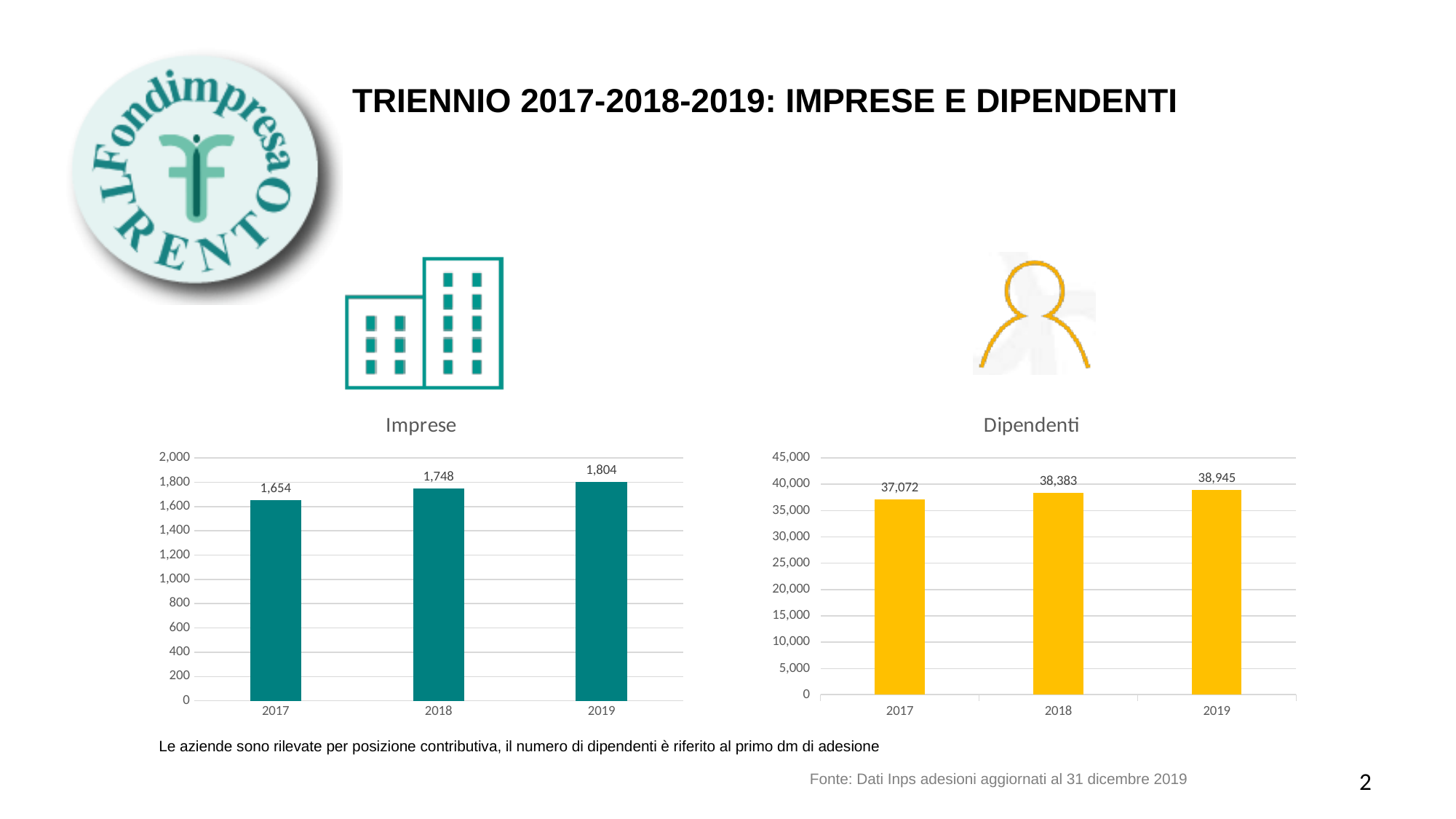
What kind of chart is the Dipendenti chart? bar chart In the Imprese chart, what is the difference between the 2019 and 2017 values? 150 In the Dipendenti chart, what is the value for 2018? 38,383 In the Imprese chart, what is the value for 2017? 1,654 In the Dipendenti chart, what is the difference between the 2018 and 2017 values? 1,311 How many years are shown in the Imprese chart? 3 In the Imprese chart, what is the value for 2019? 1,804 In the Dipendenti chart, is the value for 2019 greater or less than 40,000? less In the Imprese chart, do the values rise or fall from 2017 to 2019? rise In the Dipendenti chart, what is the value for 2019? 38,945 In the Dipendenti chart, which year has the lowest value? 2017 In the Imprese chart, which year has the highest value? 2019